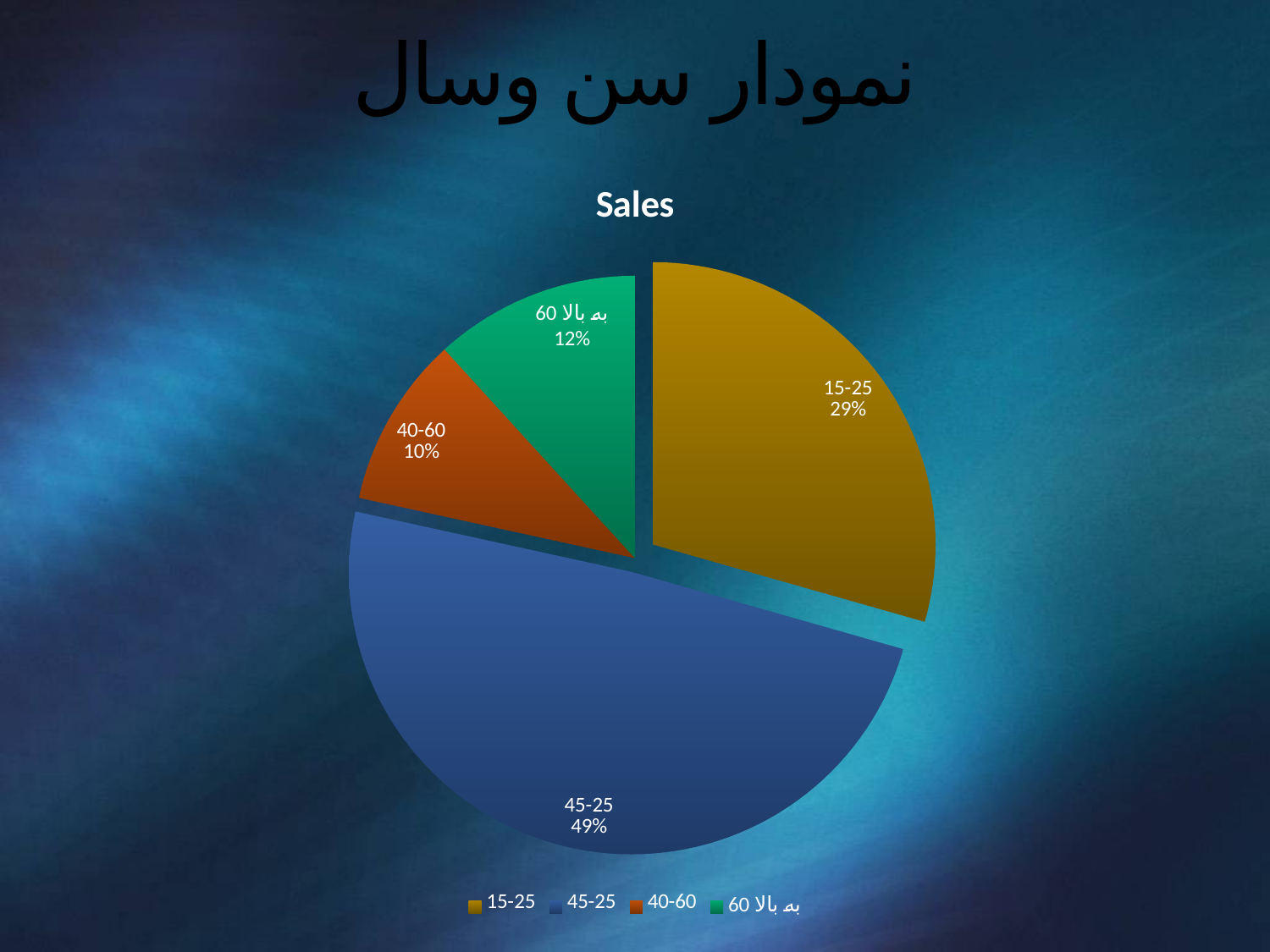
What share of the pie does the به بالا 60 slice represent? 12% What share of the pie does the 40-60 slice represent? 10% What kind of chart is shown on the slide? pie chart What is the difference in percentage points between the 45-25 slice and the 15-25 slice? 20 What share of the pie does the 15-25 slice represent? 29% Which slice is larger, به بالا 60 or 40-60? به بالا 60 Which category has the smallest slice of the pie? 40-60 How many entries does the legend list? 4 Which category has the largest slice of the pie? 45-25 How many slices does the pie chart have? 4 What is the title of the chart? Sales